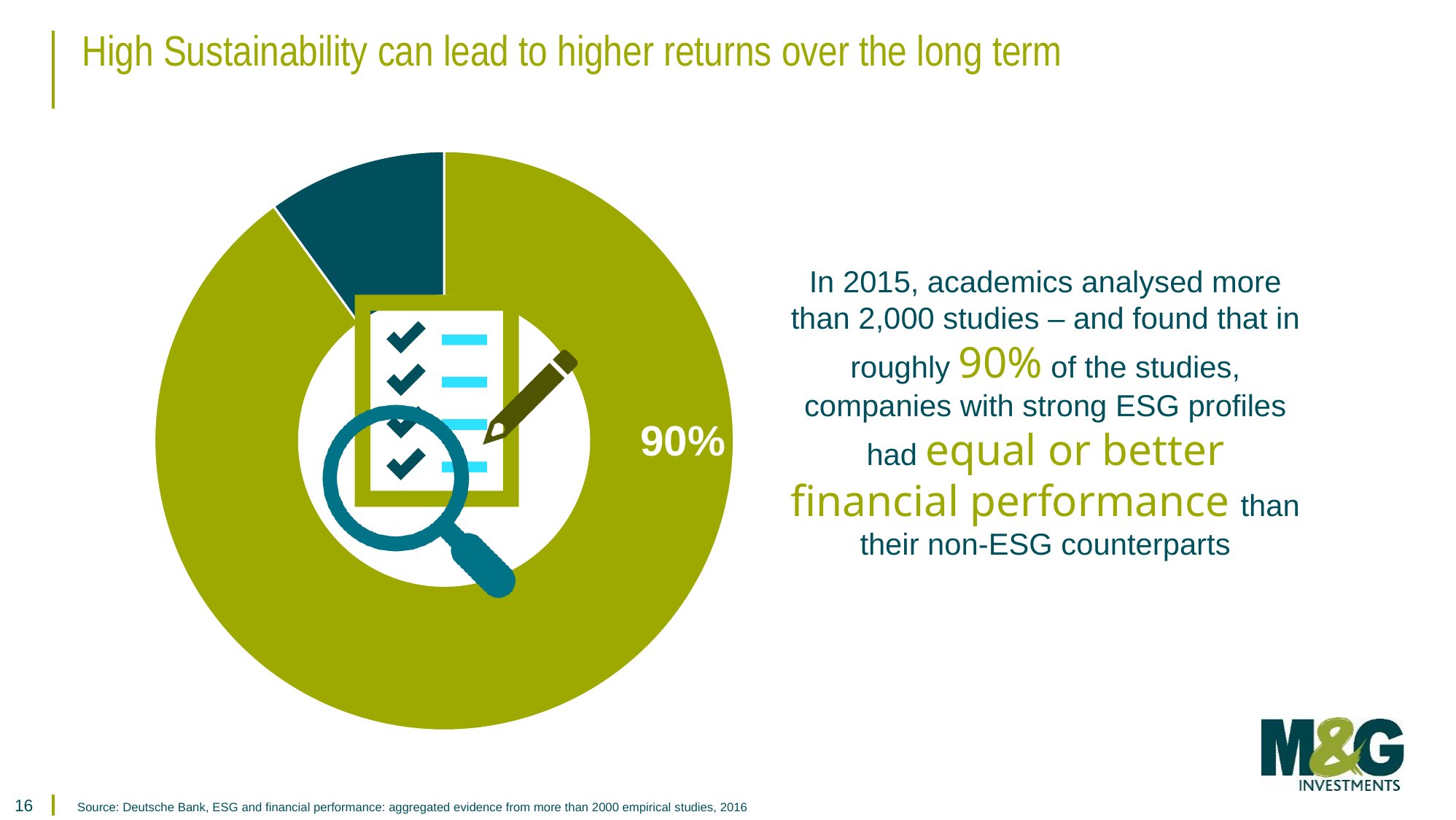
What kind of chart is shown on the slide? pie chart (donut) What is the title of the slide containing the chart? High Sustainability can lead to higher returns over the long term What value is printed on the large green slice of the chart? 90% Is the share of the green slice greater or less than 50%? greater How many slices does the chart have? 2 What share of the chart does the dark teal slice represent? 10% Which slice of the chart is larger, the green one or the dark teal one? the green one What share of the chart does the green slice represent? 90% Which slice is the smallest in the chart? the dark teal slice What colour is the slice labelled 90%? green